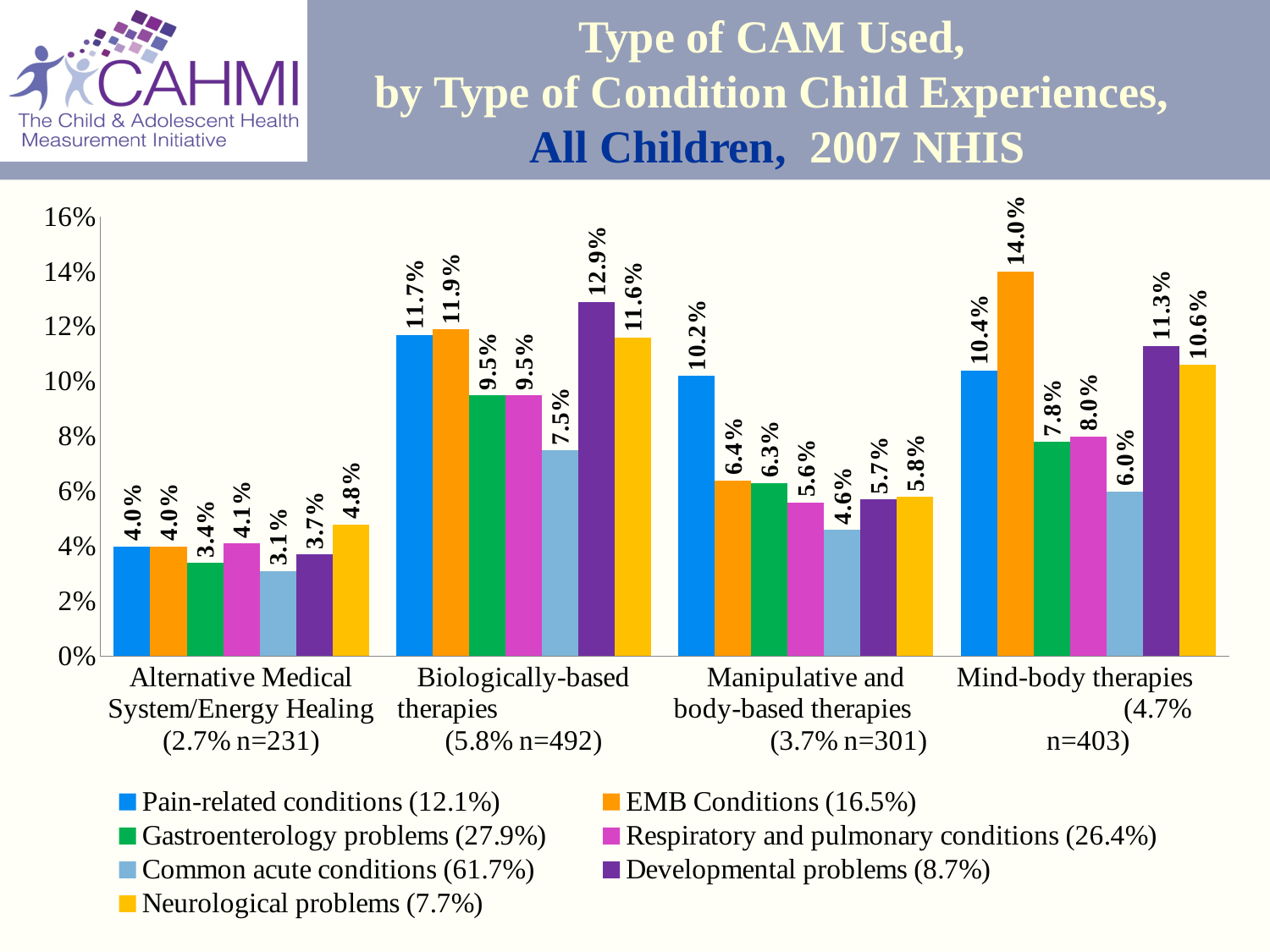
Is the value for Developmental problems in the Mind-body therapies category greater or less than 10%? greater Which series has the lowest value in the Alternative Medical System/Energy Healing category? Common acute conditions (61.7%) In the Manipulative and body-based therapies category, which is larger: Pain-related conditions or EMB Conditions? Pain-related conditions What is the value for Common acute conditions in the Mind-body therapies category? 6.0% How many categories of CAM are shown on the x axis? 4 What is the sample size (n) shown for the Biologically-based therapies category? n=492 What is the value for Developmental problems in the Biologically-based therapies category? 12.9% What is the value for Pain-related conditions in the Manipulative and body-based therapies category? 10.2% Which series has the highest value in the Mind-body therapies category? EMB Conditions (16.5%) How many series does the legend list? 7 What is the difference between EMB Conditions and Pain-related conditions in the Mind-body therapies category? 3.6% What kind of chart is shown on the slide? Bar chart